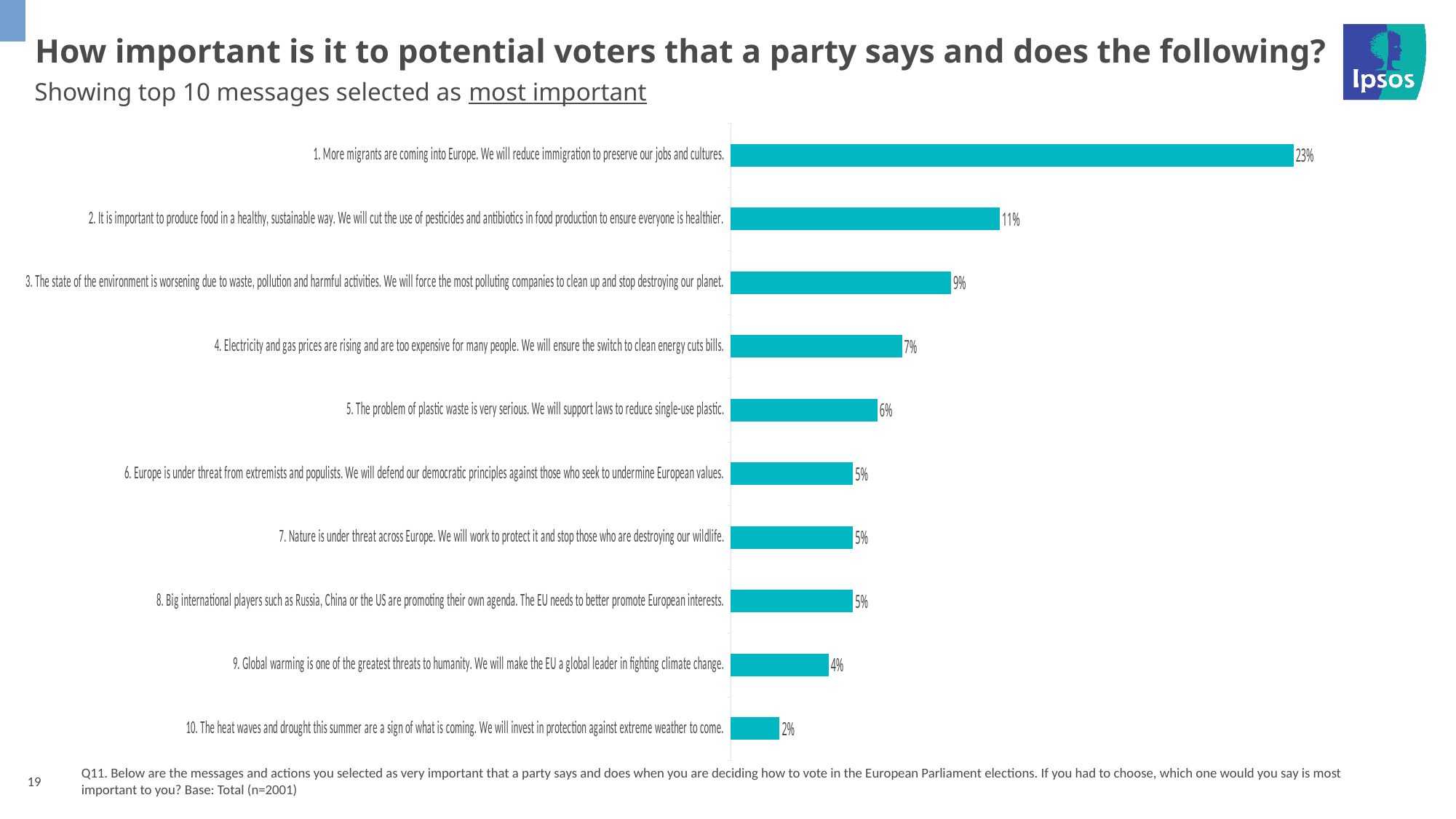
Which has a larger value: message 5 about plastic waste or message 9 about global warming? 5. The problem of plastic waste is very serious. We will support laws to reduce single-use plastic. What type of chart is shown on the slide? Bar chart Which message has the highest percentage selecting it as most important? 1. More migrants are coming into Europe. We will reduce immigration to preserve our jobs and cultures. What percentage is shown for message 9, about making the EU a global leader in fighting climate change? 4% What is the value for message 2, about producing food in a healthy, sustainable way? 11% How many messages are shown in the chart? 10 What is the difference between the value for message 3 (environment worsening) and message 4 (electricity and gas prices)? 2 What percentage selected message 1 (reducing immigration to preserve jobs and cultures) as most important? 23% Which message has the lowest percentage? 10. The heat waves and drought this summer are a sign of what is coming. We will invest in protection against extreme weather to come. How many messages share the value of 5%? 3 What is the value for message 10, about investing in protection against extreme weather? 2% What is the difference in percentage points between message 1 and message 2? 12